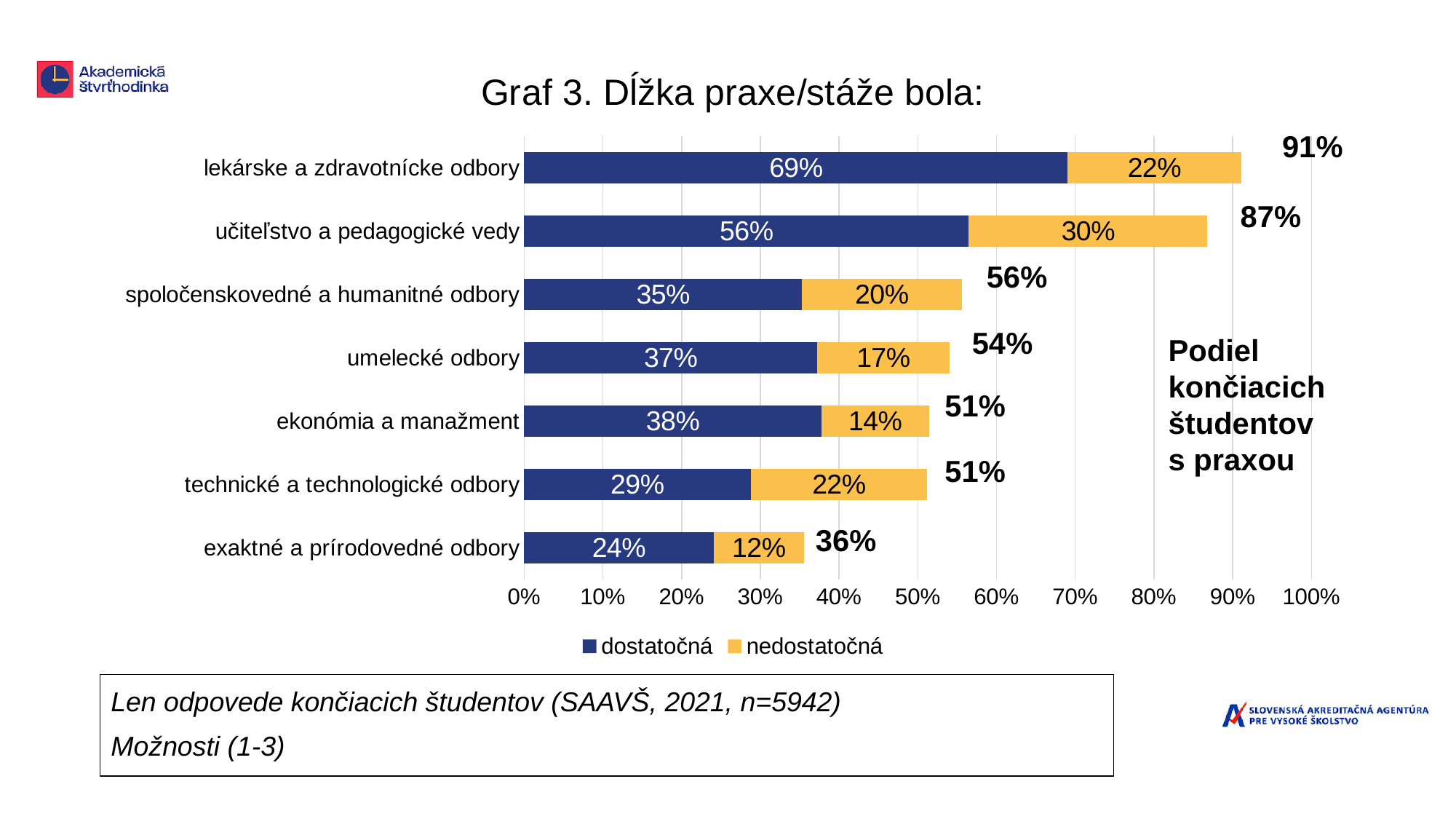
What is the value of dostatočná for lekárske a zdravotnícke odbory? 69% How many series does the legend list? 2 What is the value of nedostatočná for učiteľstvo a pedagogické vedy? 30% What is the total of the stacked bar for exaktné a prírodovedné odbory? 36% What is the difference between the dostatočná values for lekárske a zdravotnícke odbory and učiteľstvo a pedagogické vedy? 13% Which category has the highest dostatočná value? lekárske a zdravotnícke odbory What is the total of the stacked bar for technické a technologické odbory? 51% Which category has the lowest dostatočná value? exaktné a prírodovedné odbory How many categories are shown on the chart? 7 Which is larger: the nedostatočná value for umelecké odbory or for ekonómia a manažment? umelecké odbory What kind of chart is shown on the slide? stacked bar chart What is the value of nedostatočná for exaktné a prírodovedné odbory? 12%